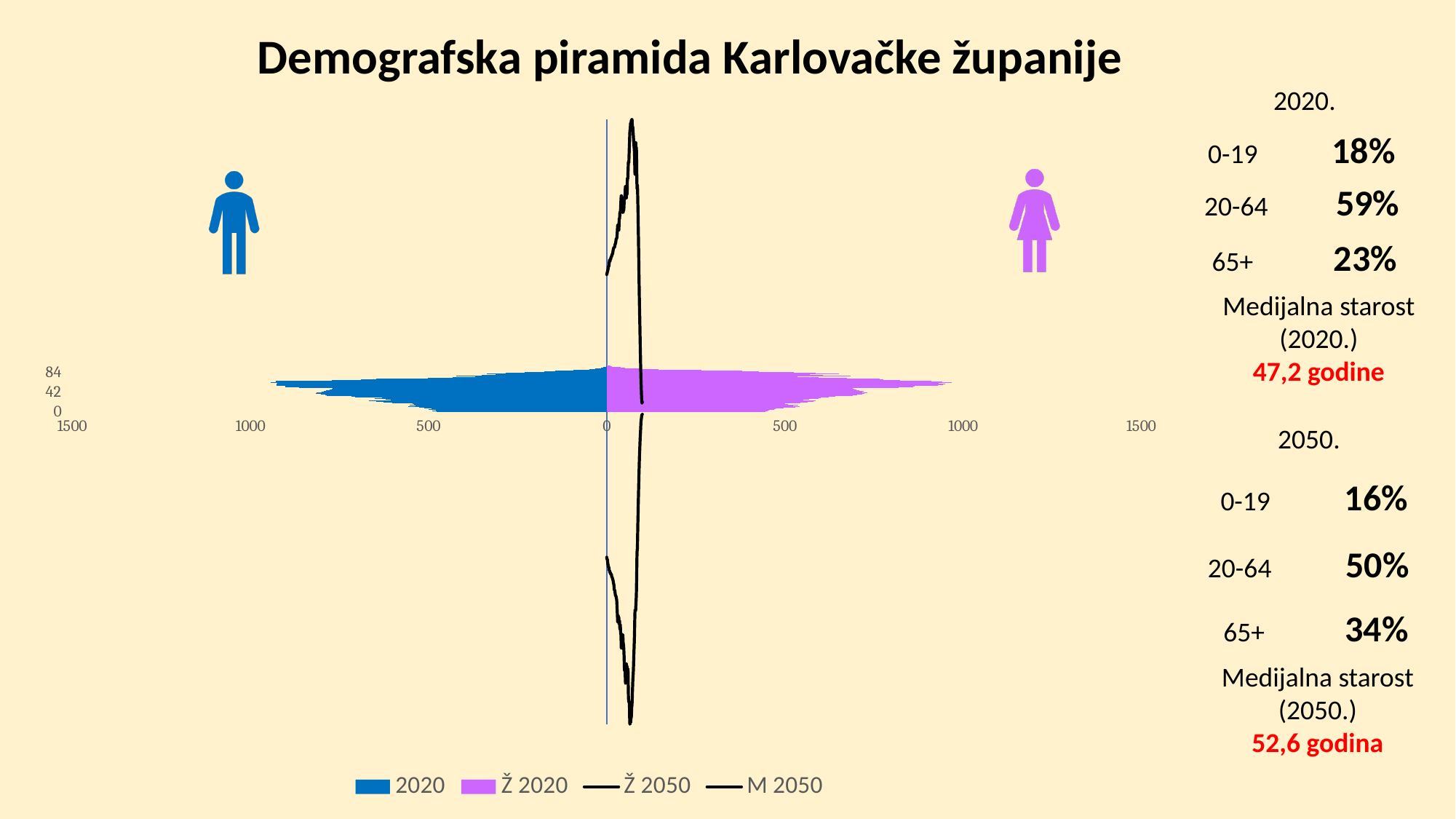
How many series does the chart legend list? 4 Is the widest extent of the blue 2020 area on the left side of the chart greater or less than 500? greater What is the title of the chart on the slide? Demografska piramida Karlovačke županije Is the widest extent of the purple Ž 2020 area on the right side of the chart greater or less than 1500? less What is the largest value shown on the horizontal axis of the chart? 1500 What is the highest tick label shown on the vertical axis of the chart? 84 Is the widest extent of the purple Ž 2020 area on the right side of the chart greater or less than 500? greater What kind of chart is the demographic pyramid on the slide? bar chart What are the series names listed in the chart legend? 2020, Ž 2020, Ž 2050, M 2050